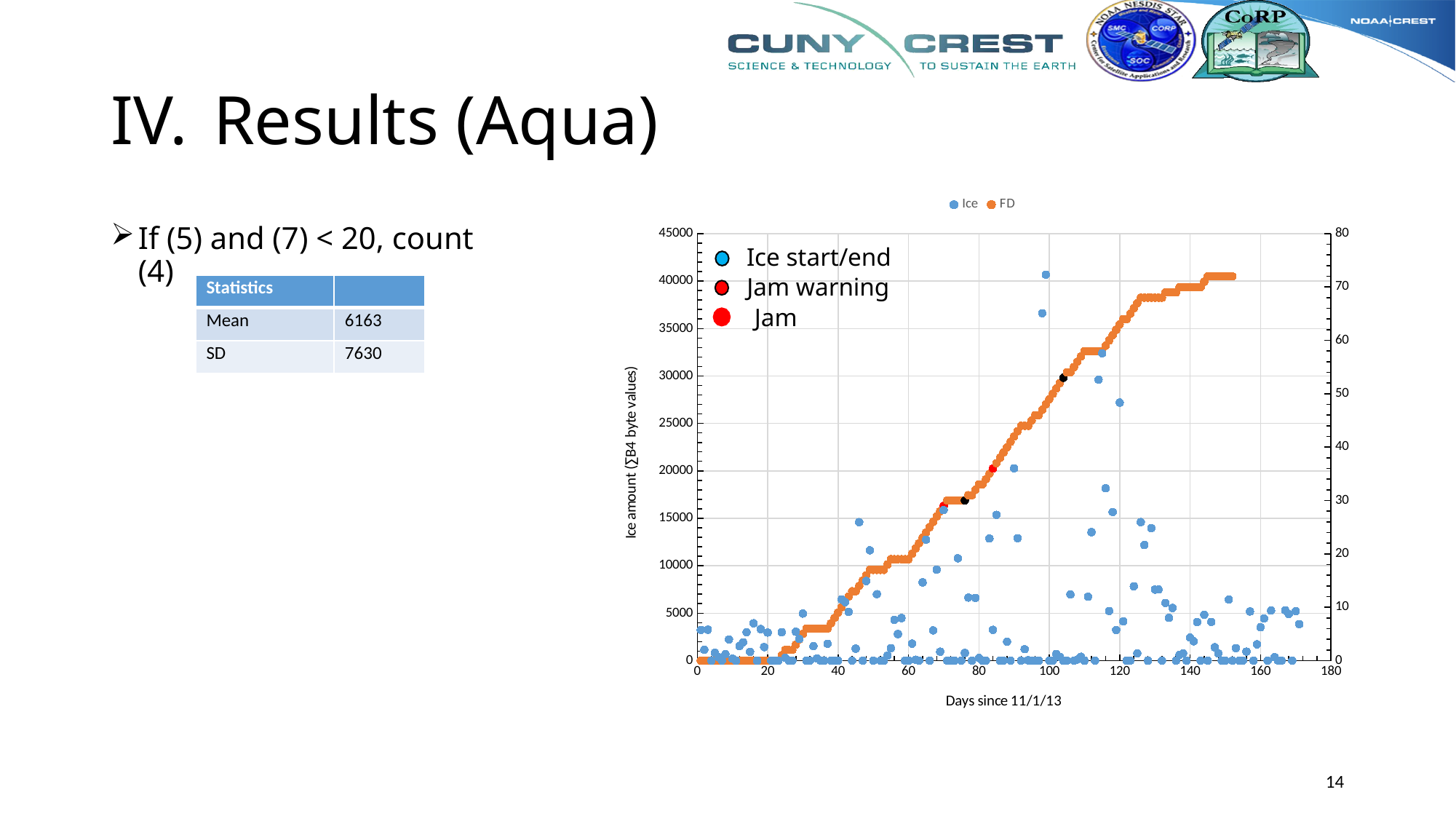
Does the FD series rise or fall as the days since 11/1/13 increase? rise What kind of chart is shown on the slide? scatter chart Is the highest Ice value on the chart greater or less than 35000 on the left axis? greater What is the title of the x axis of the chart? Days since 11/1/13 At day 140, which series is plotted higher on the chart, Ice or FD? FD Is the Ice value at day 160 greater or less than 20000 on the left axis? less Is the FD value at day 10 greater or less than 5000 on the left axis? less How many series does the chart legend list? 2 What are the two series named in the chart legend? Ice and FD